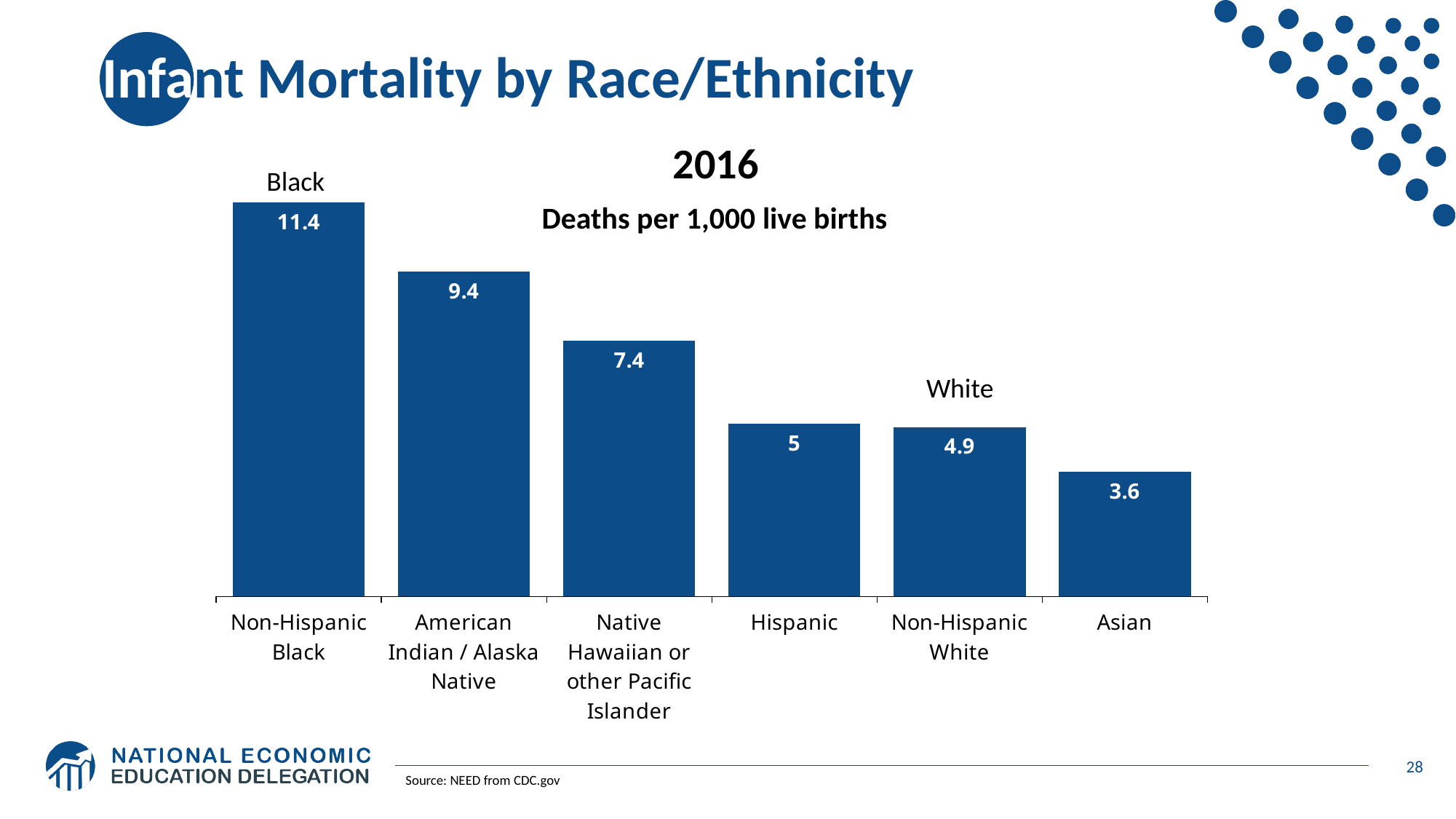
How many race/ethnicity categories are shown in the chart? 6 What is the value shown for Asian? 3.6 Which category has the highest infant mortality rate? Non-Hispanic Black What is the value shown for Native Hawaiian or other Pacific Islander? 7.4 What is the difference between the Hispanic and Asian values? 1.4 What is the infant mortality rate for Non-Hispanic Black in 2016? 11.4 Which category has the lowest infant mortality rate? Asian What unit is the chart measured in, according to the subtitle? Deaths per 1,000 live births What kind of chart is shown on the slide? Bar chart What is the difference between the Non-Hispanic Black and Non-Hispanic White values? 6.5 What is the value shown for American Indian / Alaska Native? 9.4 Which is larger, the value for Hispanic or the value for Non-Hispanic White? Hispanic